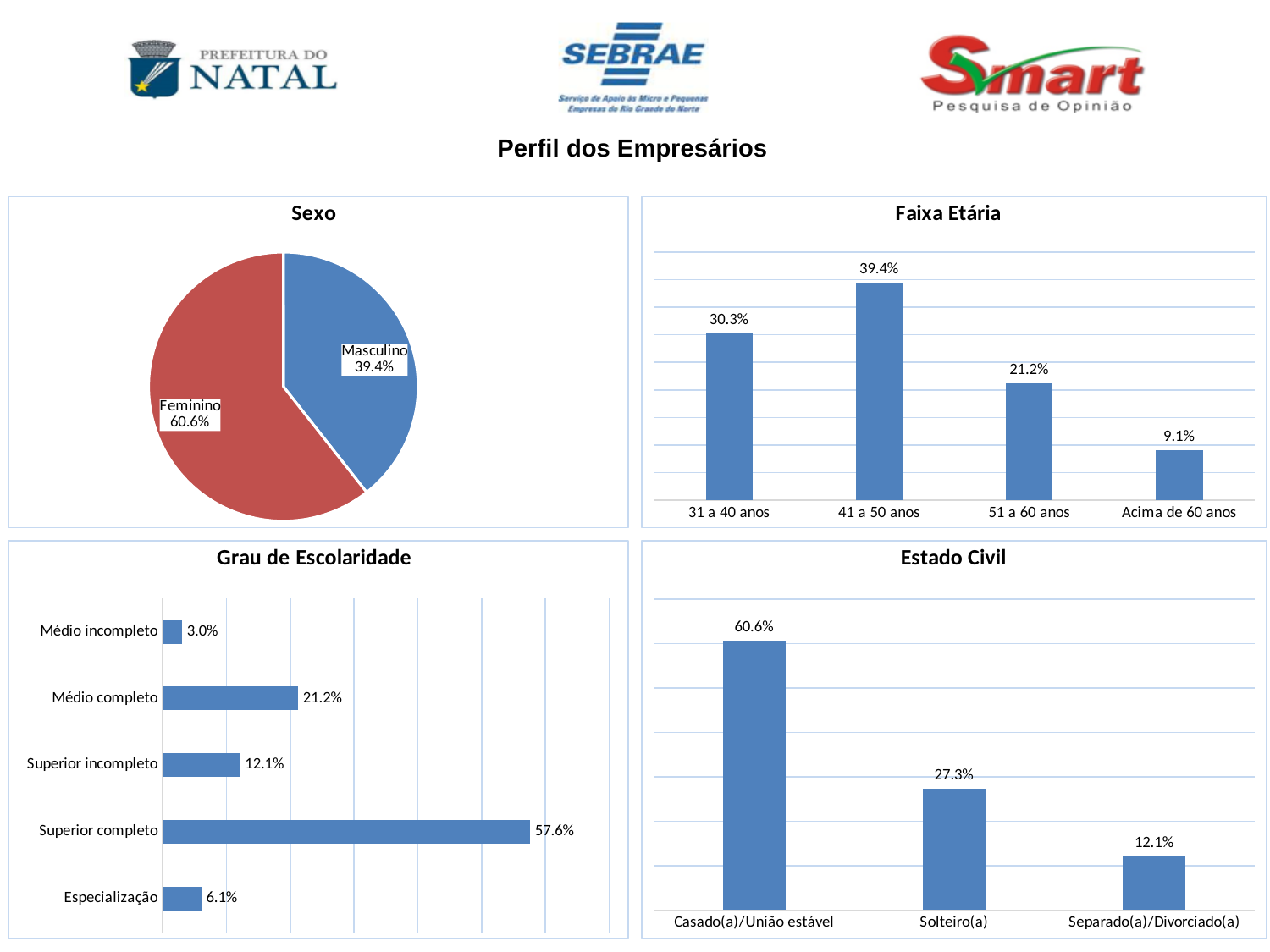
In the 'Estado Civil' chart, what is the value for Solteiro(a)? 27.3% In the 'Sexo' chart, what kind of chart is shown? Pie chart In the 'Faixa Etária' chart, which age group has the lowest value? Acima de 60 anos In the 'Faixa Etária' chart, what is the value for 41 a 50 anos? 39.4% In the 'Faixa Etária' chart, how many age groups are shown? 4 In the 'Grau de Escolaridade' chart, what kind of chart is shown? Bar chart In the 'Grau de Escolaridade' chart, which is larger: Médio completo or Especialização? Médio completo In the 'Estado Civil' chart, what is the difference between Casado(a)/União estável and Separado(a)/Divorciado(a)? 48.5% In the 'Faixa Etária' chart, what is the difference between 31 a 40 anos and 51 a 60 anos? 9.1% In the 'Grau de Escolaridade' chart, what is the value for Superior incompleto? 12.1% In the 'Grau de Escolaridade' chart, which category has the highest value? Superior completo In the 'Sexo' chart, what share of the pie is Feminino? 60.6%